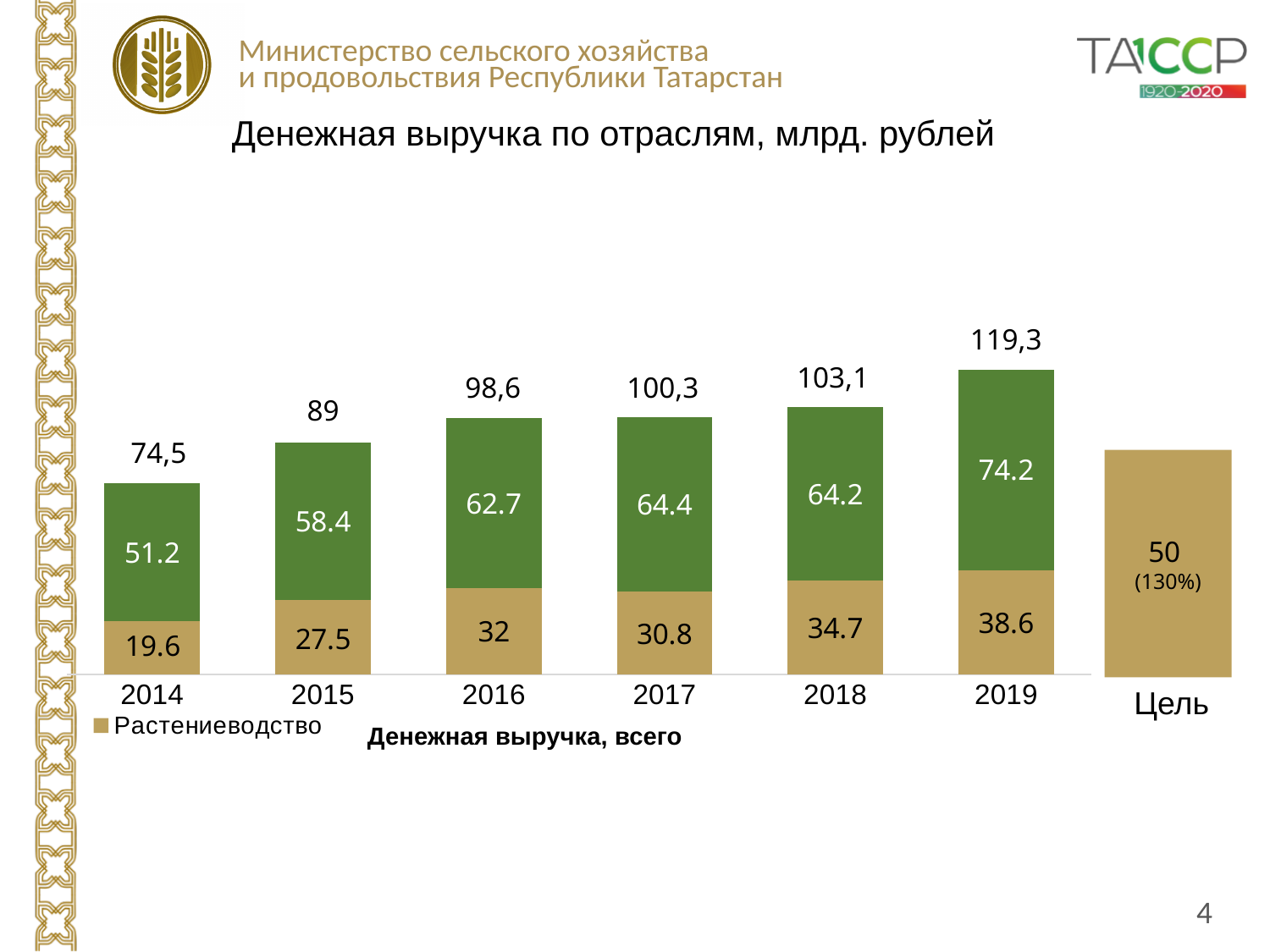
Which year has the lowest value for Растениеводство? 2014 What kind of chart is shown on the slide? Stacked bar chart Which year has the highest total cash revenue? 2019 By how much did Растениеводство increase from 2014 to 2019? 19 What is the value of Растениеводство for 2014? 19.6 Which year has the larger Растениеводство value, 2016 or 2017? 2016 What is the total cash revenue (Денежная выручка, всего) shown for 2019? 119,3 What is the value of the green segment for 2017? 64.4 What value is shown for the Цель bar? 50 (130%) What is the difference between the total cash revenue in 2019 and 2018? 16,2 Does the total cash revenue rise or fall from 2014 to 2019? Rises How many years are shown on the x axis (excluding the Цель bar)? 6